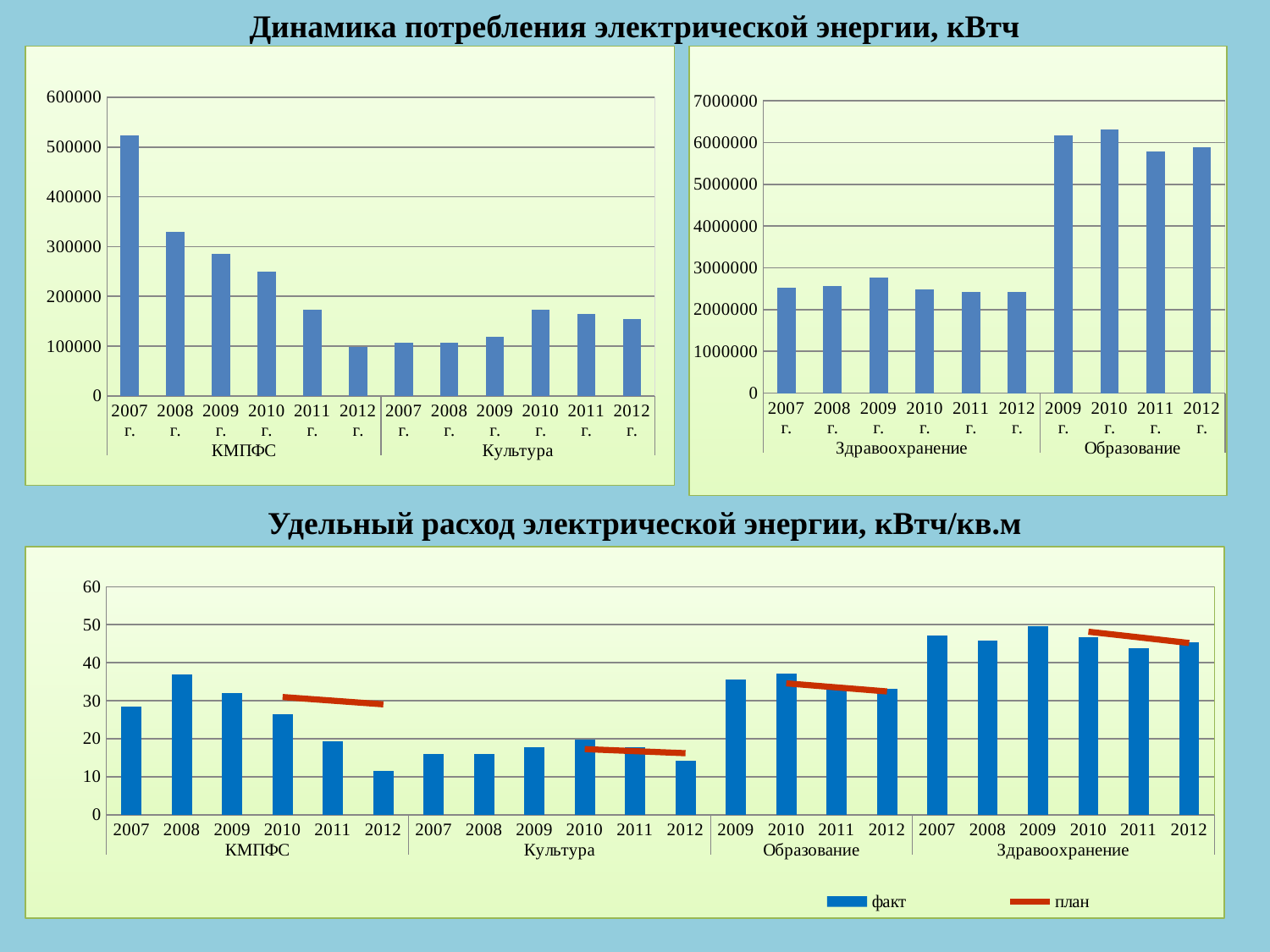
In the top-left chart, is the value for КМПФС in 2007 г. greater or less than 500000? greater In the top-right chart, is the value for Здравоохранение in 2009 г. greater or less than 3000000? less What are the two legend entries of the bottom chart? факт, план In the top-left chart (Динамика потребления электрической энергии), which bar is the highest? КМПФС 2007 г. In the top-right chart, is the value for Образование in 2010 г. greater or less than 6000000? greater What kind of chart is the bottom chart (Удельный расход электрической энергии)? combination bar and line chart How many series does the legend of the bottom chart (Удельный расход электрической энергии) list? 2 In the top-left chart, do the КМПФС values rise or fall from 2007 г. to 2012 г.? fall In the bottom chart, which факт bar is the highest? Здравоохранение 2009 In the top-right chart, which group has the higher values, Здравоохранение or Образование? Образование How many bars are plotted in the top-left chart? 12 In the bottom chart, which факт bar is the lowest? КМПФС 2012